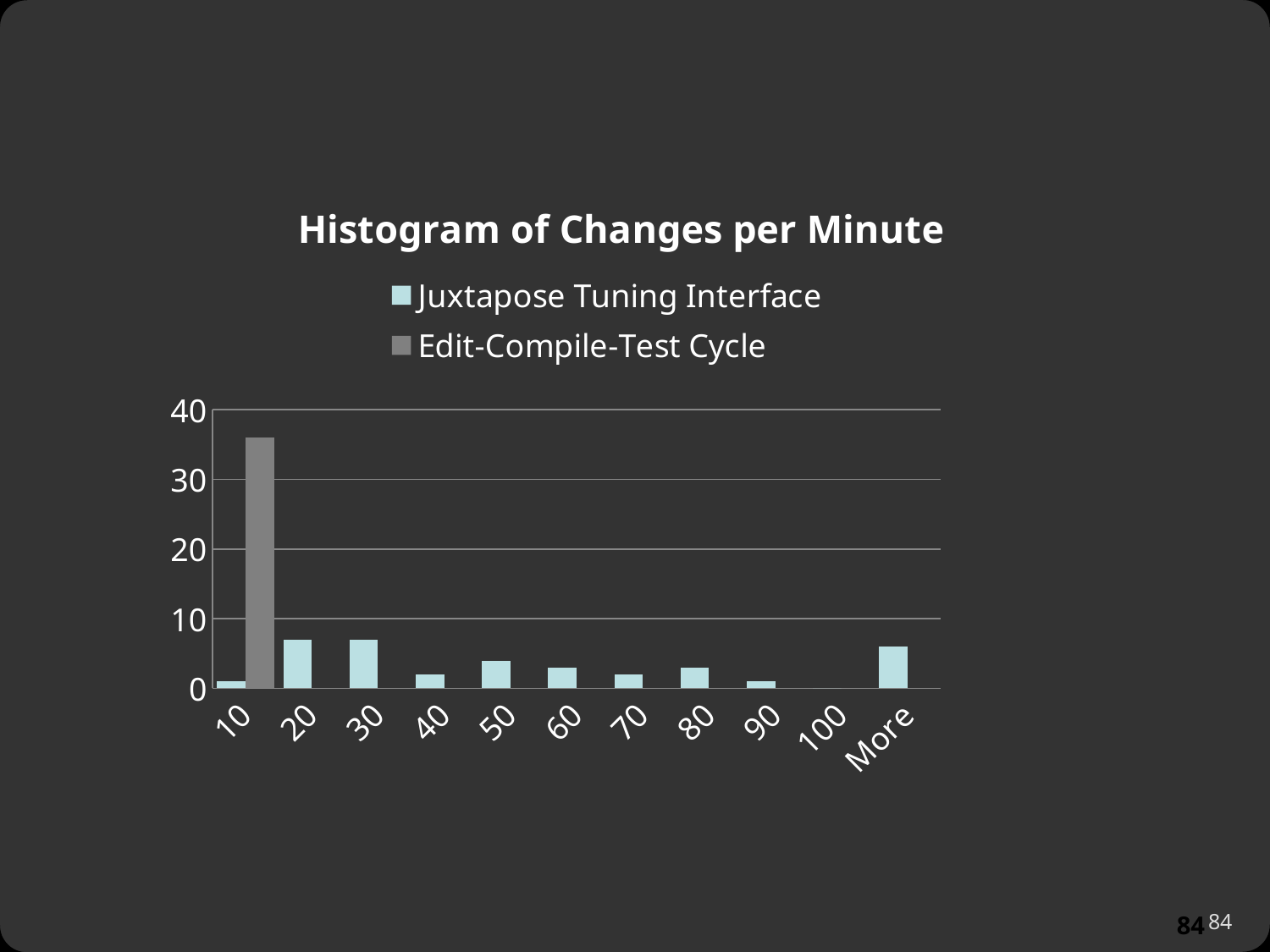
How many categories are shown on the x axis? 11 For the Juxtapose Tuning Interface series, which category has the larger value, 40 or 50? 50 What is the title of the chart? Histogram of Changes per Minute Is the Edit-Compile-Test Cycle value for the 10 category greater or less than 30? greater In which category does the Edit-Compile-Test Cycle series have its highest value? 10 Which series is shown in gray in the legend? Edit-Compile-Test Cycle Is the Juxtapose Tuning Interface value for the More category greater or less than 10? less Is the Juxtapose Tuning Interface value for the 20 category greater or less than 10? less How many series does the legend list? 2 For the 10 category, which series has the larger value, Juxtapose Tuning Interface or Edit-Compile-Test Cycle? Edit-Compile-Test Cycle What kind of chart is shown on the slide? bar chart